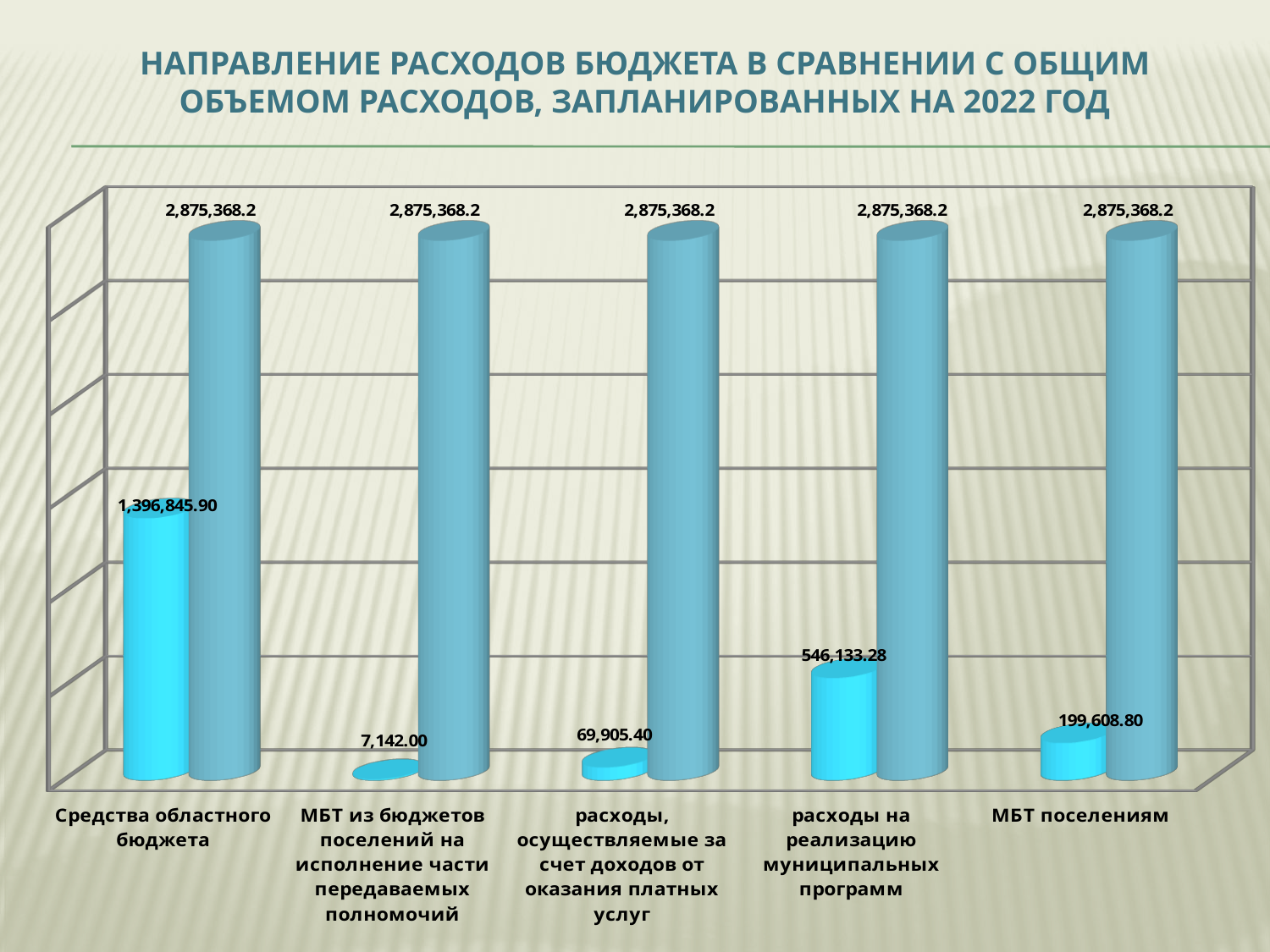
What is the difference between the total planned expenditure (2,875,368.2) and the value for Средства областного бюджета (1,396,845.90)? 1,478,522.30 What value is shown on the tall bar repeated for every category? 2,875,368.2 How many categories are shown on the x axis of the chart? 5 What kind of chart is shown on the slide? Bar chart What is the title of the slide? Направление расходов бюджета в сравнении с общим объемом расходов, запланированных на 2022 год Which is larger: the smaller bar for расходы, осуществляемые за счет доходов от оказания платных услуг or the smaller bar for МБТ поселениям? МБТ поселениям What is the value of the smaller (light blue) bar for Средства областного бюджета? 1,396,845.90 Which category has the lowest value among the smaller (light blue) bars? МБТ из бюджетов поселений на исполнение части передаваемых полномочий What is the value of the smaller bar for расходы на реализацию муниципальных программ? 546,133.28 Which category has the highest value among the smaller (light blue) bars? Средства областного бюджета What is the value of the smaller bar for МБТ поселениям? 199,608.80 What is the difference between the smaller bars for расходы на реализацию муниципальных программ and МБТ поселениям? 346,524.48